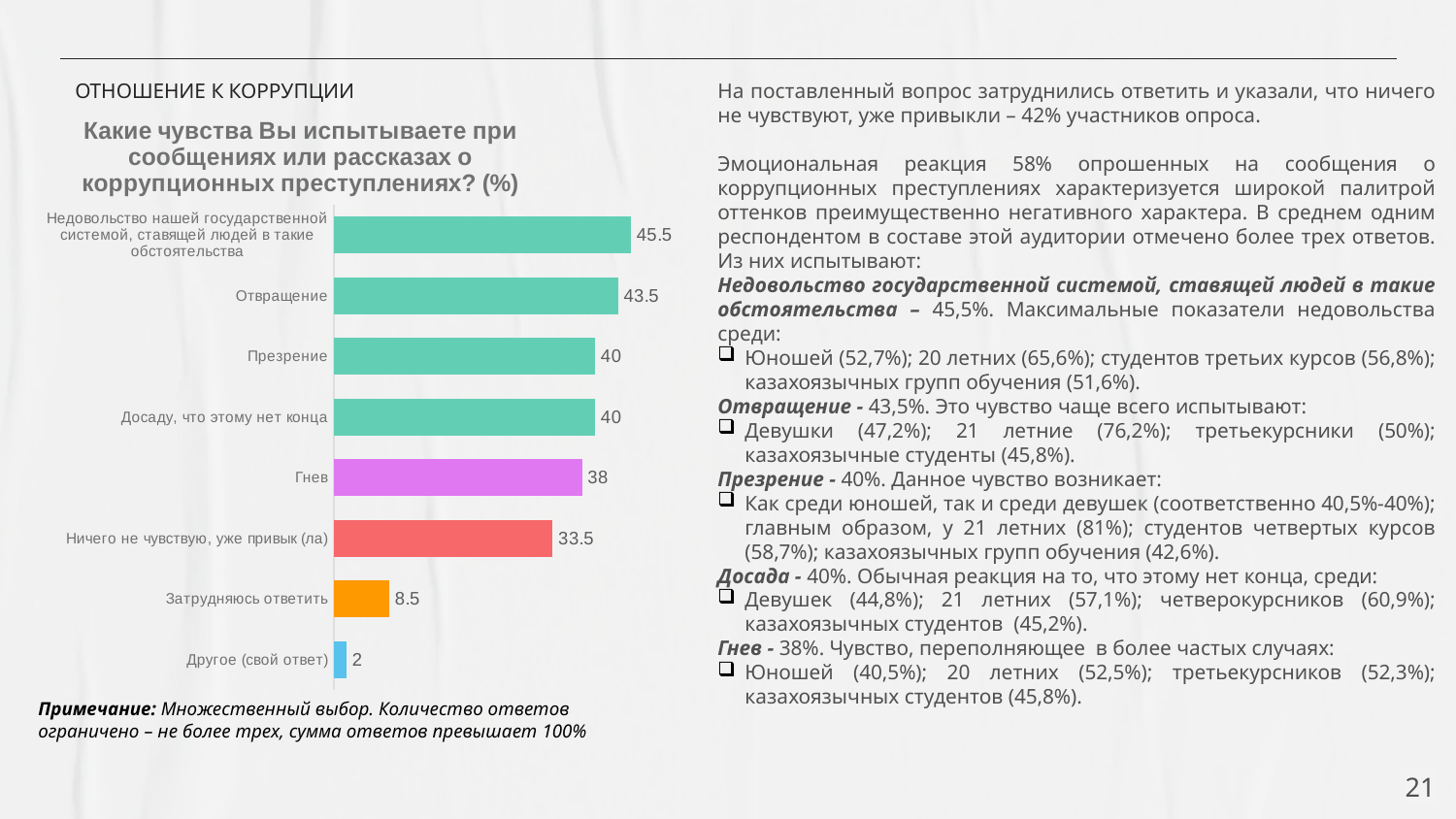
What is the value for "Ничего не чувствую, уже привык (ла)"? 33.5 What is the difference between the values for "Ничего не чувствую, уже привык (ла)" and "Затрудняюсь ответить"? 25 What is the value for "Затрудняюсь ответить"? 8.5 What is the value for "Гнев"? 38 What is the difference between the values for "Отвращение" and "Гнев"? 5.5 What is the value for "Отвращение"? 43.5 Which category has the lowest value? Другое (свой ответ) How many categories are shown in the chart? 8 Which is larger, the value for "Презрение" or the value for "Гнев"? Презрение What kind of chart is shown on the slide? Bar chart Which category has the highest value? Недовольство нашей государственной системой, ставящей людей в такие обстоятельства What is the title of the chart? Какие чувства Вы испытываете при сообщениях или рассказах о коррупционных преступлениях? (%)